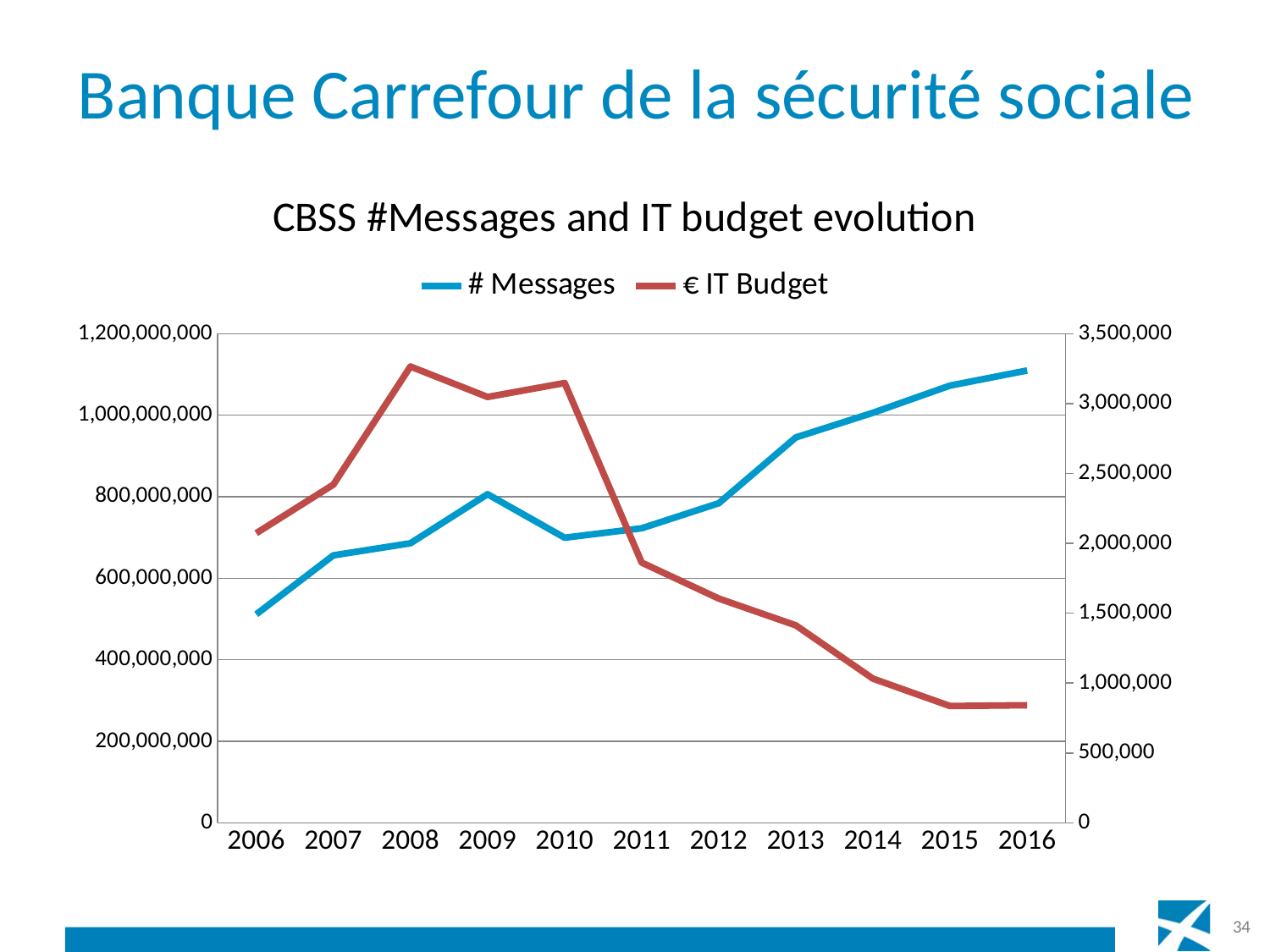
What kind of chart is shown on the slide? Line chart Is the # Messages value for 2006 greater or less than 600,000,000? less Is the # Messages value for 2016 greater or less than 1,000,000,000? greater In which year does the € IT Budget series reach its peak? 2008 How many series does the legend list? 2 Does the € IT Budget series rise or fall from 2010 to 2016? Fall Which year has the larger # Messages value, 2009 or 2010? 2009 In which year is the # Messages series at its highest? 2016 In which year is the # Messages series at its lowest? 2006 Is the € IT Budget value for 2008 greater or less than 3,000,000? greater How many years are plotted along the x axis? 11